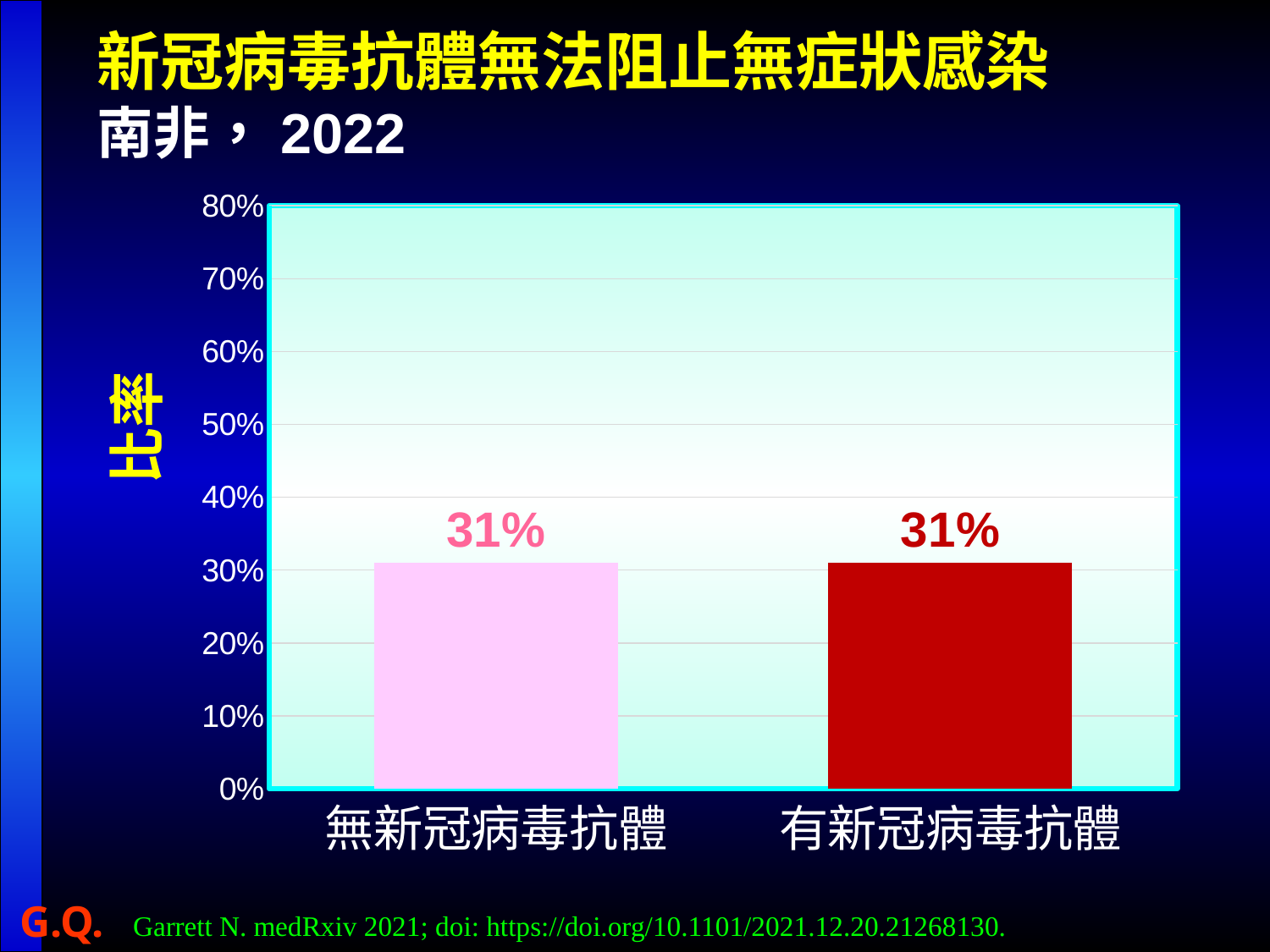
What is the difference between the values for 無新冠病毒抗體 and 有新冠病毒抗體? 0% Which is larger, the value for 無新冠病毒抗體 or the value for 有新冠病毒抗體? They are equal (both 31%) What is the value for 有新冠病毒抗體? 31% What kind of chart is shown on the slide? Bar chart What is the label of the y axis? 比率 Is the value for 有新冠病毒抗體 greater or less than 40%? less What is the highest value shown on the y axis? 80% Is the value for 無新冠病毒抗體 greater or less than 20%? greater How many categories are shown on the x axis? 2 What is the value for 無新冠病毒抗體? 31%